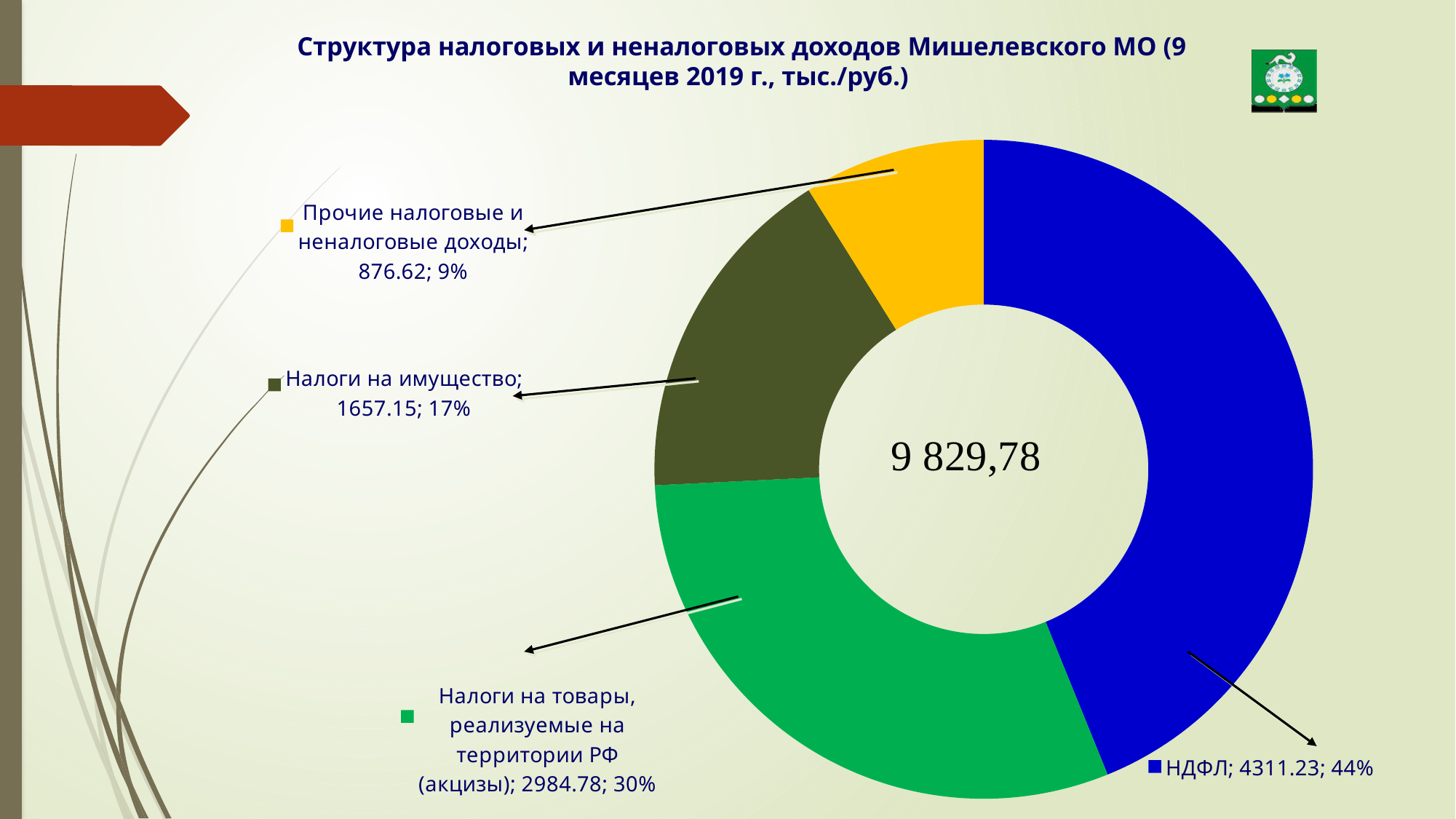
What type of chart is shown on the slide? Doughnut (pie) chart What is the value for Налоги на товары, реализуемые на территории РФ (акцизы)? 2984.78 What is the value for НДФЛ? 4311.23 What is the value for Налоги на имущество? 1657.15 Which category has the smallest share of the chart? Прочие налоговые и неналоговые доходы What percentage share does НДФЛ have? 44% What is the difference between the values for НДФЛ and Налоги на имущество? 2654.08 Which category has the largest share of the chart? НДФЛ How many categories are shown in the chart? 4 What total value is printed in the centre of the doughnut chart? 9 829,78 What is the value for Прочие налоговые и неналоговые доходы? 876.62 What percentage share does Налоги на имущество have? 17%